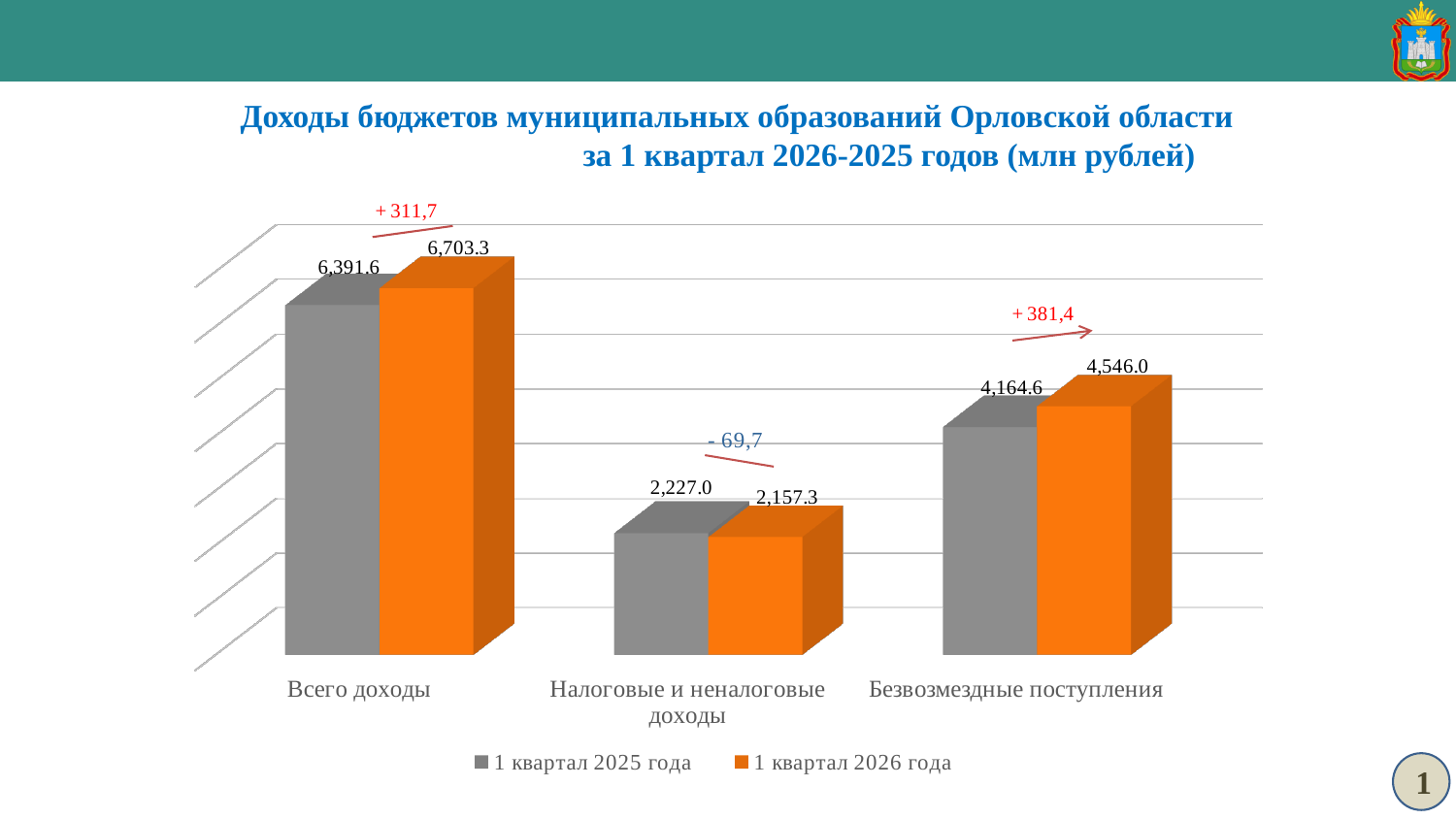
For Налоговые и неналоговые доходы, which series has the larger value: 1 квартал 2025 года or 1 квартал 2026 года? 1 квартал 2025 года Which category has the highest value in the 1 квартал 2025 года series? Всего доходы What change is annotated above the bars for Всего доходы? + 311,7 How many series does the legend list? 2 How many categories are shown on the x axis? 3 Which category has the lowest value in the 1 квартал 2026 года series? Налоговые и неналоговые доходы What is the value for Всего доходы in the 1 квартал 2025 года series? 6,391.6 What is the difference between the 1 квартал 2026 года and 1 квартал 2025 года values for Безвозмездные поступления? 381.4 What is the value for Всего доходы in the 1 квартал 2026 года series? 6,703.3 What is the value for Налоговые и неналоговые доходы in the 1 квартал 2026 года series? 2,157.3 What is the value for Безвозмездные поступления in the 1 квартал 2025 года series? 4,164.6 What kind of chart is shown on the slide? Bar chart